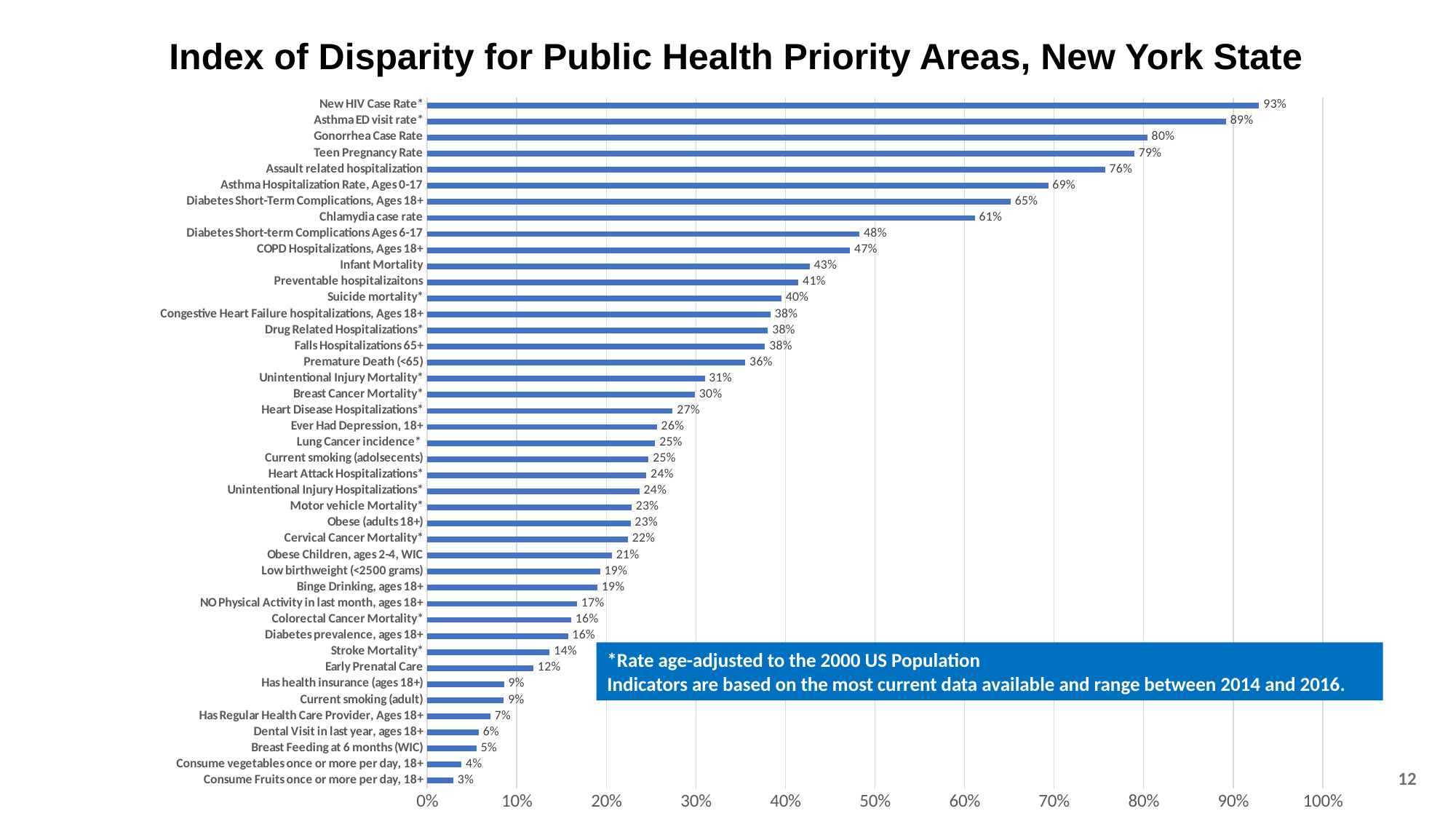
What kind of chart is shown on the slide? Bar chart Which category has the lowest Index of Disparity? Consume Fruits once or more per day, 18+ Which category has the highest Index of Disparity? New HIV Case Rate* What is the value shown for Infant Mortality? 43% Which is larger, the value for Suicide mortality* or the value for Premature Death (<65)? Suicide mortality* What is the value shown for Early Prenatal Care? 12% What is the difference between the values for Chlamydia case rate and Teen Pregnancy Rate? 18% What is the difference between the values for New HIV Case Rate* and Asthma ED visit rate*? 4% What is the title of the chart? Index of Disparity for Public Health Priority Areas, New York State How many categories are plotted in the chart? 43 Is the value for Assault related hospitalization greater or less than 70%? greater What is the Index of Disparity value for Gonorrhea Case Rate? 80%